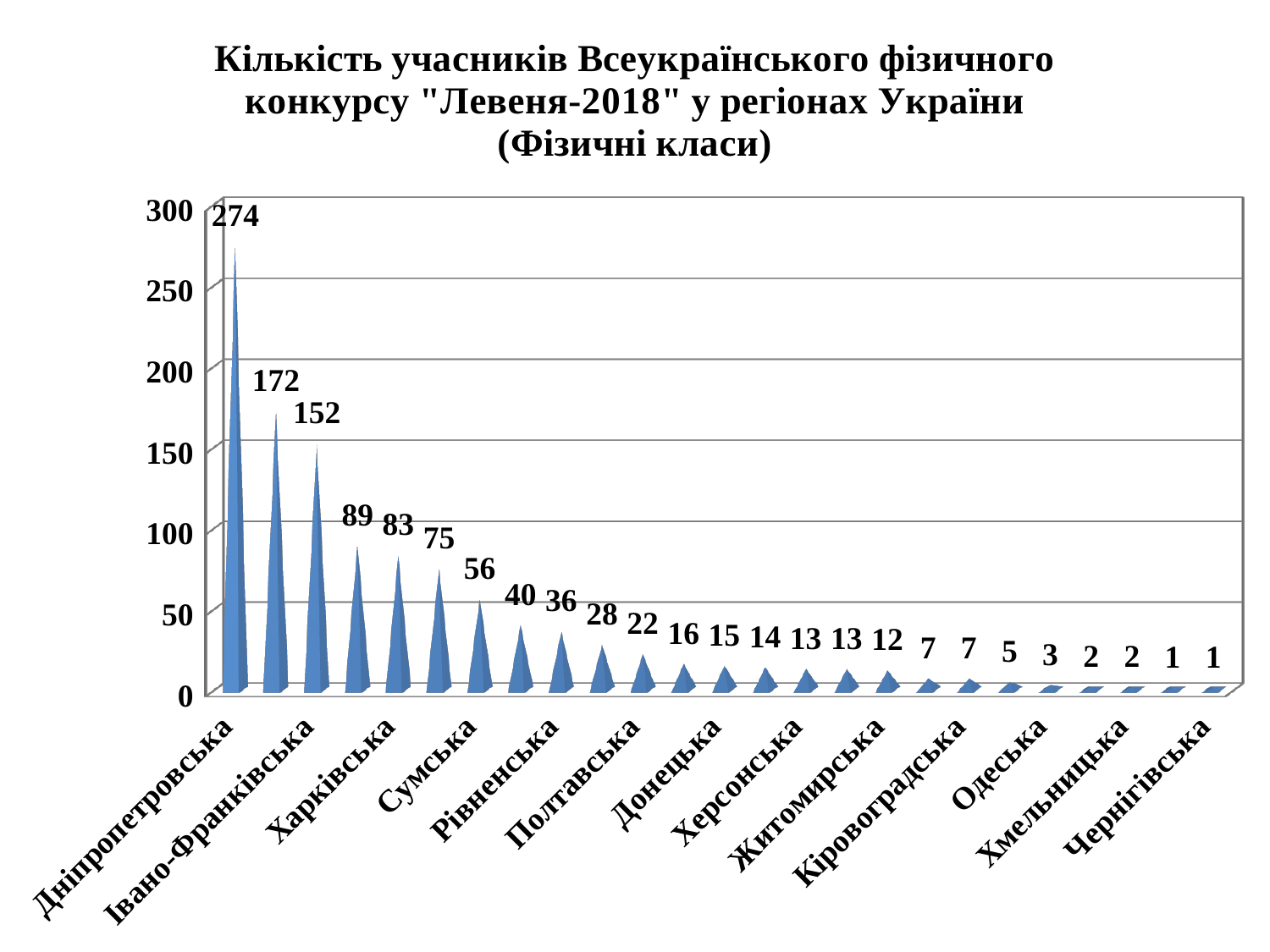
How many participants are shown for Сумська? 56 What is the difference between the values for Дніпропетровська and Харківська? 191 How many participants are shown for Чернігівська? 1 Which has more participants, Сумська or Рівненська? Сумська How many participants are shown for Харківська? 83 Is the value for Дніпропетровська greater or less than 250? greater How many participants are shown for Одеська? 3 What is the highest value printed on the chart? 274 Do the values rise or fall from left to right along the x axis? fall How many participants are shown for Дніпропетровська? 274 Which region has the highest number of participants? Дніпропетровська What kind of chart is shown on the slide? bar chart